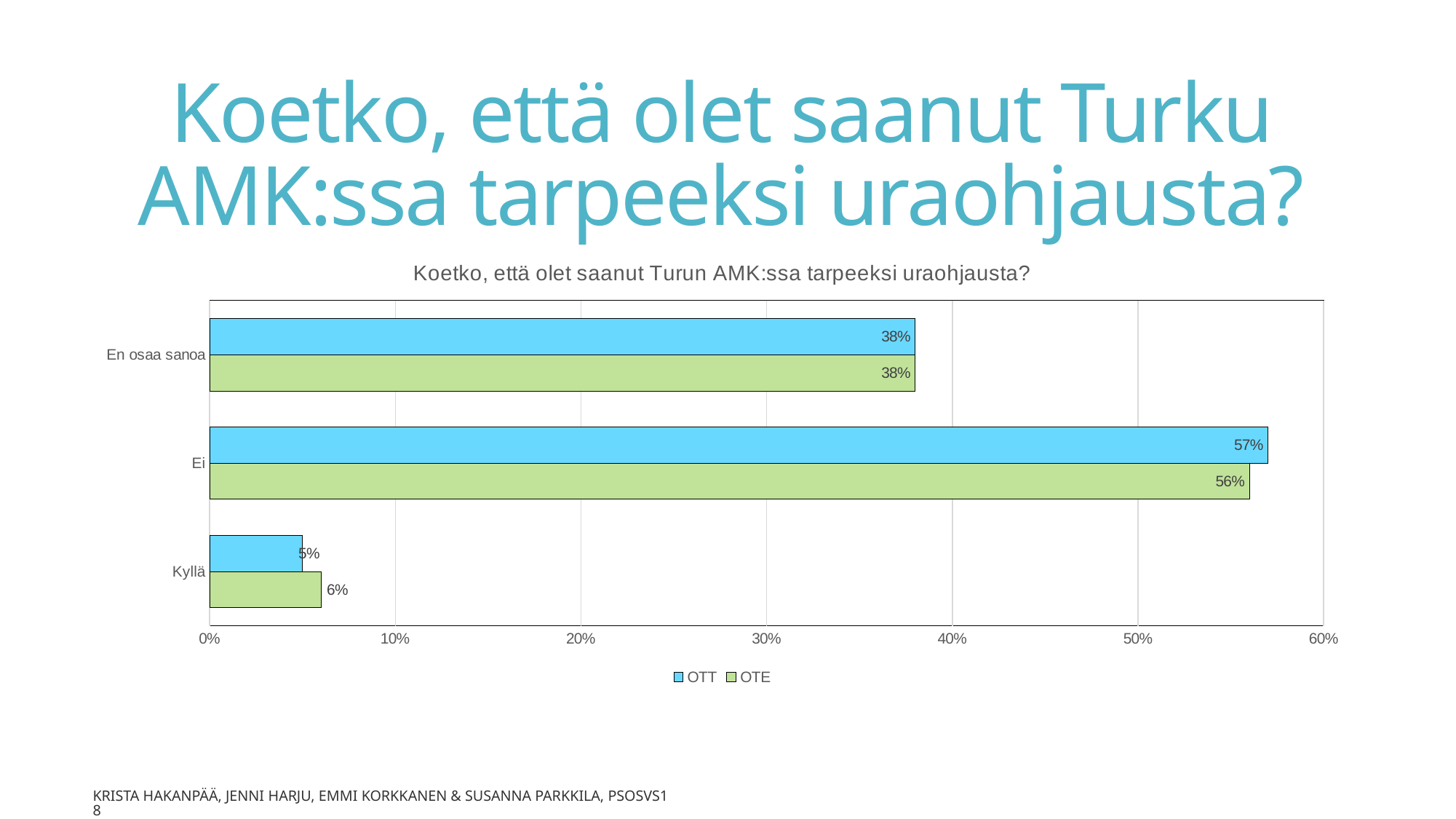
Is the OTE value for "Ei" greater or less than 50%? greater What is the OTE value for "En osaa sanoa"? 38% What are the two series named in the legend? OTT and OTE What is the difference between the OTT and OTE values for "Ei"? 1% How many categories are shown on the chart? 3 Which category has the highest OTT value? Ei What kind of chart is shown on the slide? Bar chart Which category has the lowest OTE value? Kyllä How many series does the legend list? 2 What is the OTE value for "Kyllä"? 6% What is the difference between the OTT values for "Ei" and "Kyllä"? 52% What is the OTT value for "Ei"? 57%